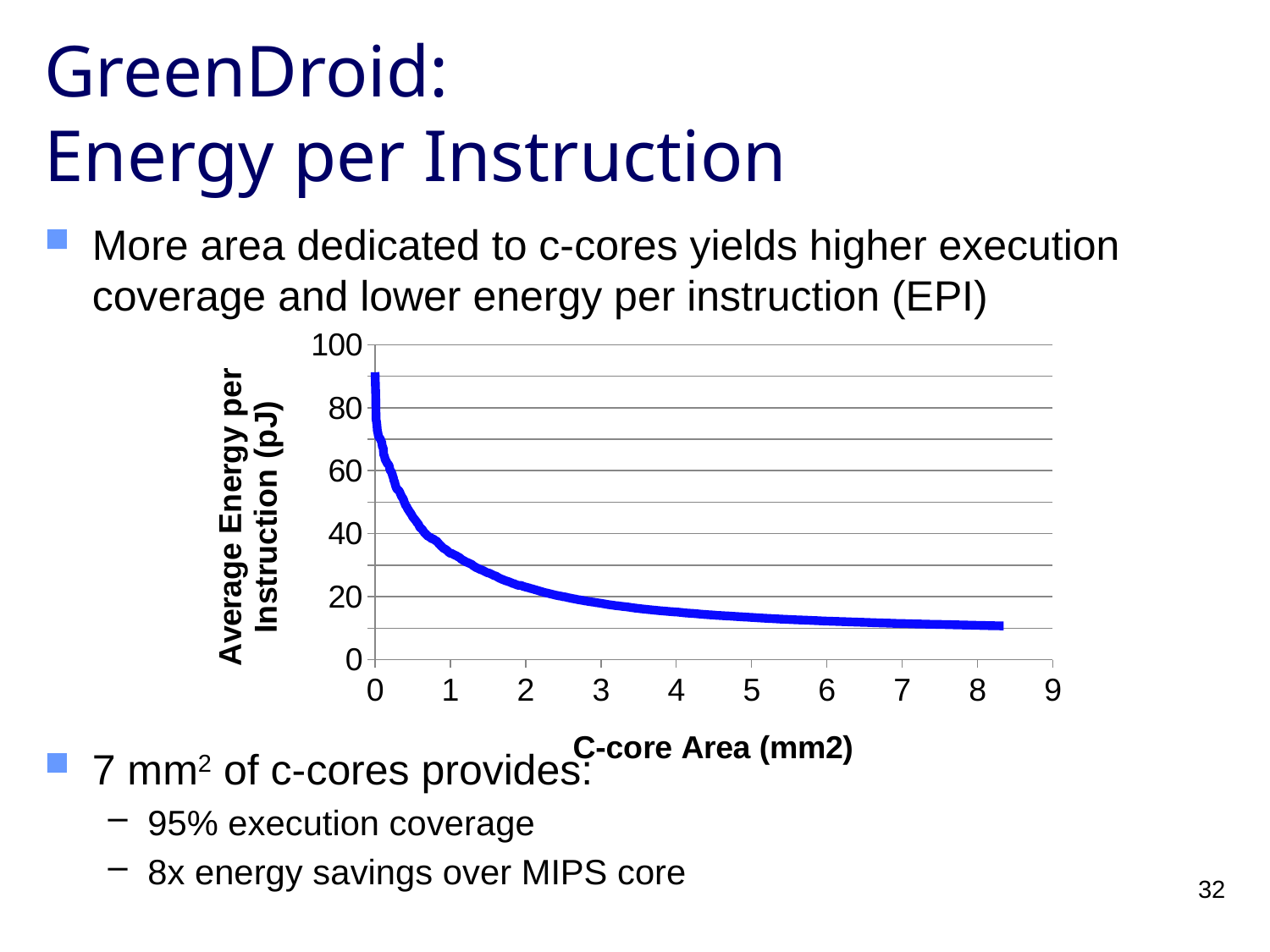
Is the average energy per instruction at a c-core area of 6 mm2 greater or less than 40 pJ? less At which end of the x axis is the average energy per instruction highest, 0 mm2 or 8 mm2? 0 mm2 What is the highest value shown on the vertical axis of the chart? 100 What is the label of the vertical axis of the chart? Average Energy per Instruction (pJ) Is the average energy per instruction at a c-core area of 2 mm2 greater or less than 40 pJ? less Is the average energy per instruction at a c-core area of 0 mm2 greater or less than 80 pJ? greater Does the average energy per instruction rise or fall as the c-core area increases? fall What kind of chart is shown on the slide? line chart What is the label of the horizontal axis of the chart? C-core Area (mm2)